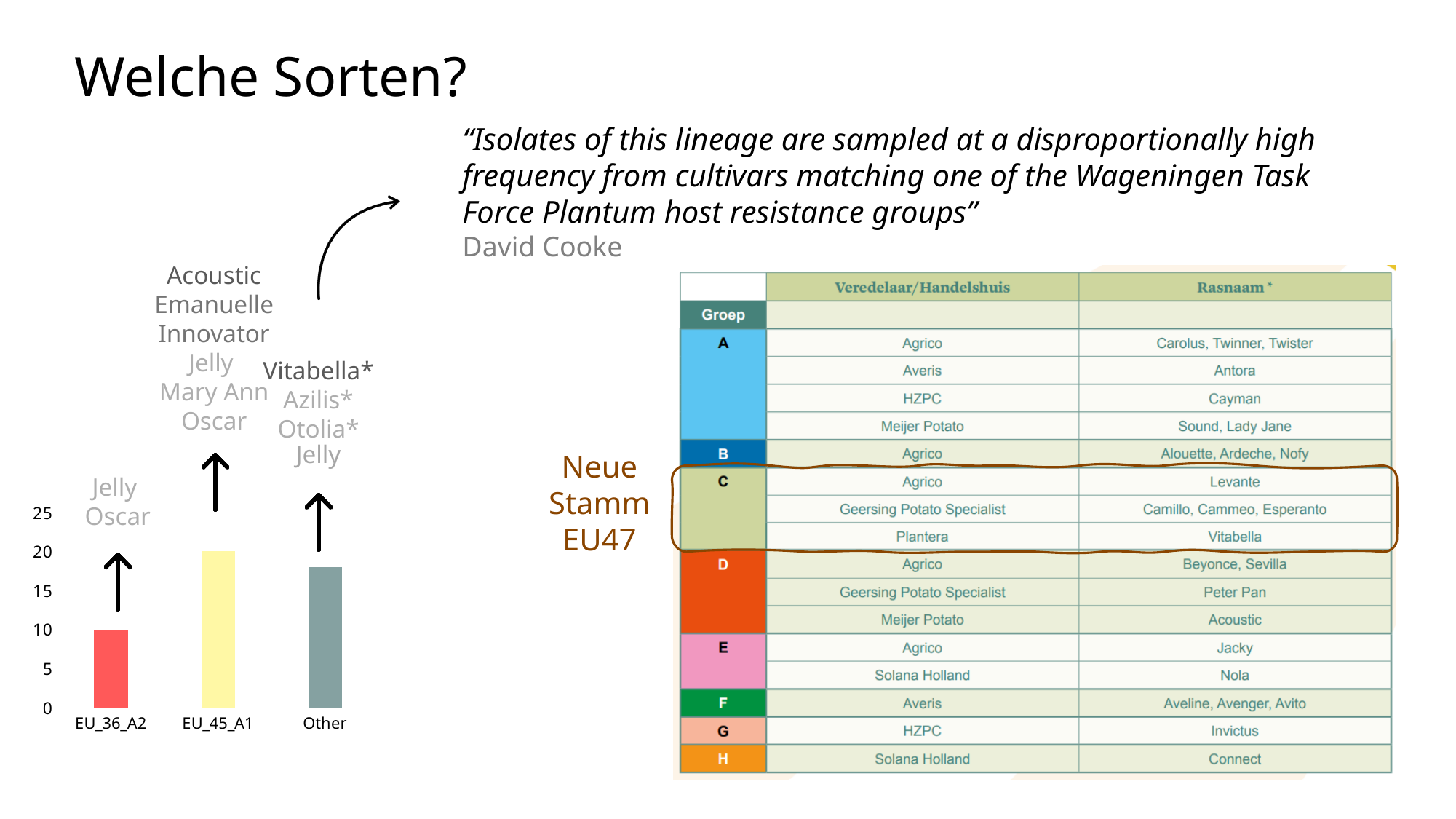
What kind of chart is shown on the left of the slide? bar chart Which category has the shortest bar? EU_36_A2 Which category has the tallest bar? EU_45_A1 What is the value of the bar for EU_45_A1? 20 What is the value of the bar for EU_36_A2? 10 Is the value for Other greater or less than 20? less How many categories are shown on the x axis of the bar chart? 3 What is the highest tick value shown on the y axis of the bar chart? 25 Which is larger, the bar for Other or the bar for EU_36_A2? Other Is the value for Other greater or less than 15? greater What colour is the bar for EU_45_A1? yellow What is the difference between the values for EU_45_A1 and EU_36_A2? 10